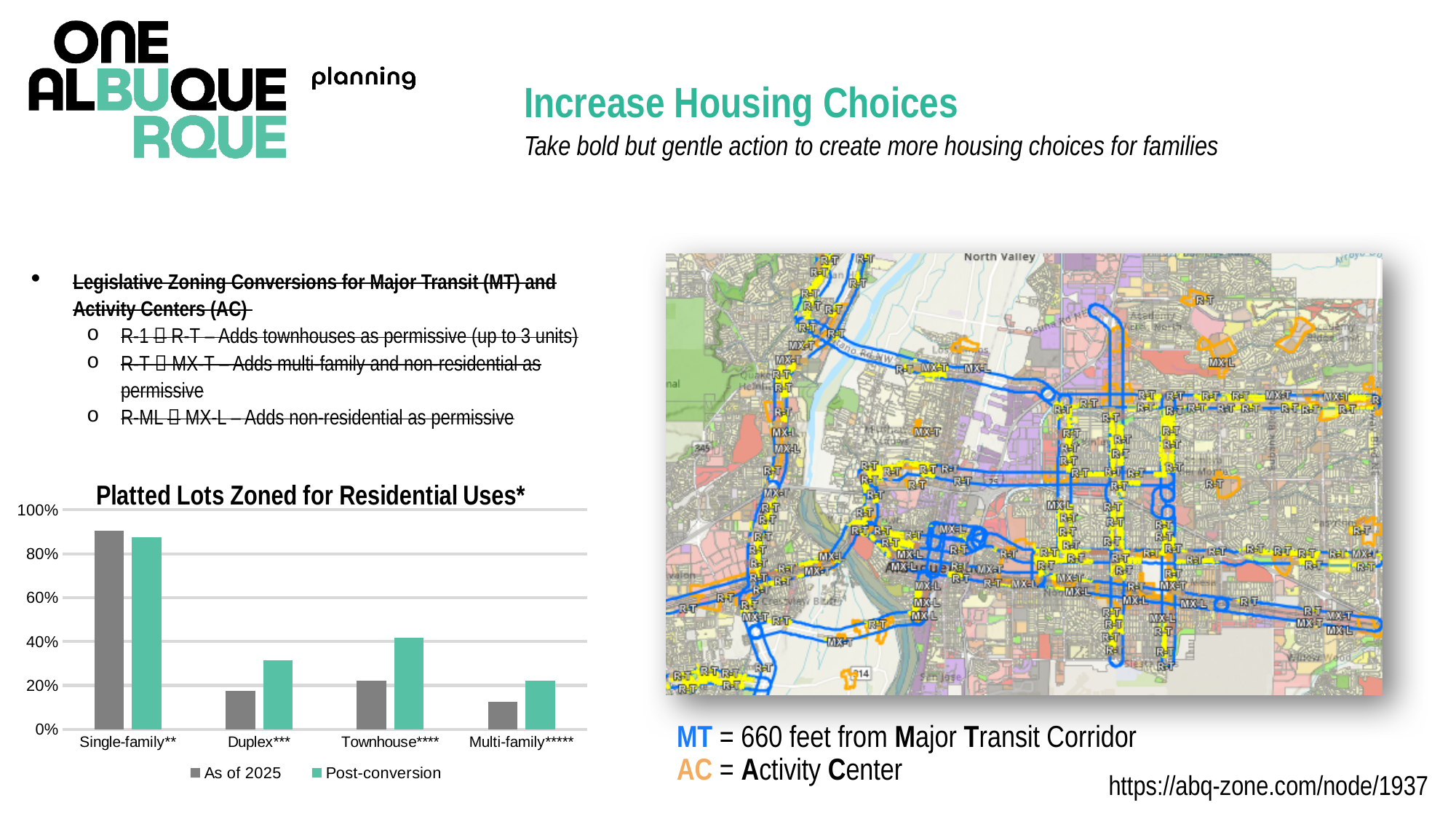
What are the two series named in the legend of the "Platted Lots Zoned for Residential Uses*" chart? As of 2025 and Post-conversion In the "Platted Lots Zoned for Residential Uses*" chart, which category has the lowest As of 2025 value? Multi-family***** In the "Platted Lots Zoned for Residential Uses*" chart, which category has the lowest Post-conversion value? Multi-family***** How many series does the legend of the "Platted Lots Zoned for Residential Uses*" chart list? 2 In the "Platted Lots Zoned for Residential Uses*" chart, which has the larger Post-conversion value: Townhouse**** or Duplex***? Townhouse**** In the "Platted Lots Zoned for Residential Uses*" chart, which is larger for Duplex***: the As of 2025 value or the Post-conversion value? Post-conversion In the "Platted Lots Zoned for Residential Uses*" chart, is the As of 2025 value for Single-family** greater or less than 80%? greater In the "Platted Lots Zoned for Residential Uses*" chart, which category has the highest As of 2025 value? Single-family** How many categories are shown on the x axis of the "Platted Lots Zoned for Residential Uses*" chart? 4 In the "Platted Lots Zoned for Residential Uses*" chart, is the Post-conversion value for Duplex*** greater or less than 20%? greater What type of chart is "Platted Lots Zoned for Residential Uses*"? bar chart In the "Platted Lots Zoned for Residential Uses*" chart, is the As of 2025 value for Multi-family***** greater or less than 20%? less